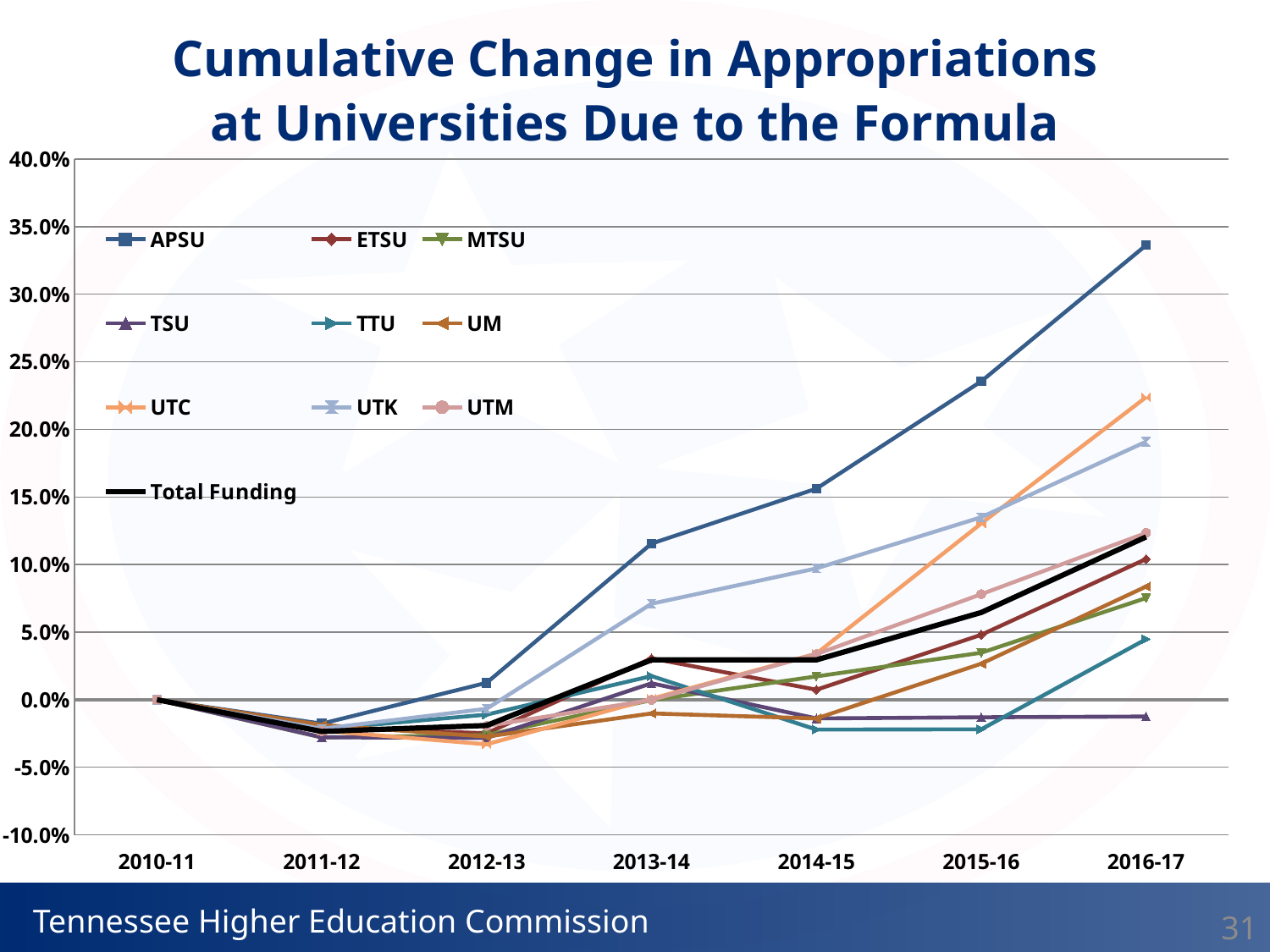
How many series does the legend list? 10 Is the value for Total Funding in 2016-17 greater or less than 10.0%? greater Does the APSU line rise or fall from 2012-13 to 2016-17? rise What kind of chart is shown on the slide? line chart What is the value for APSU in 2010-11? 0.0% Is the value for APSU in 2016-17 greater or less than 30.0%? greater Is the value for UTC in 2016-17 greater or less than 20.0%? greater Which series has the highest value in 2016-17? APSU In 2014-15, which is larger: the value for APSU or the value for UTK? APSU Which series has the lowest value in 2016-17? TSU How many fiscal years are shown along the x axis? 7